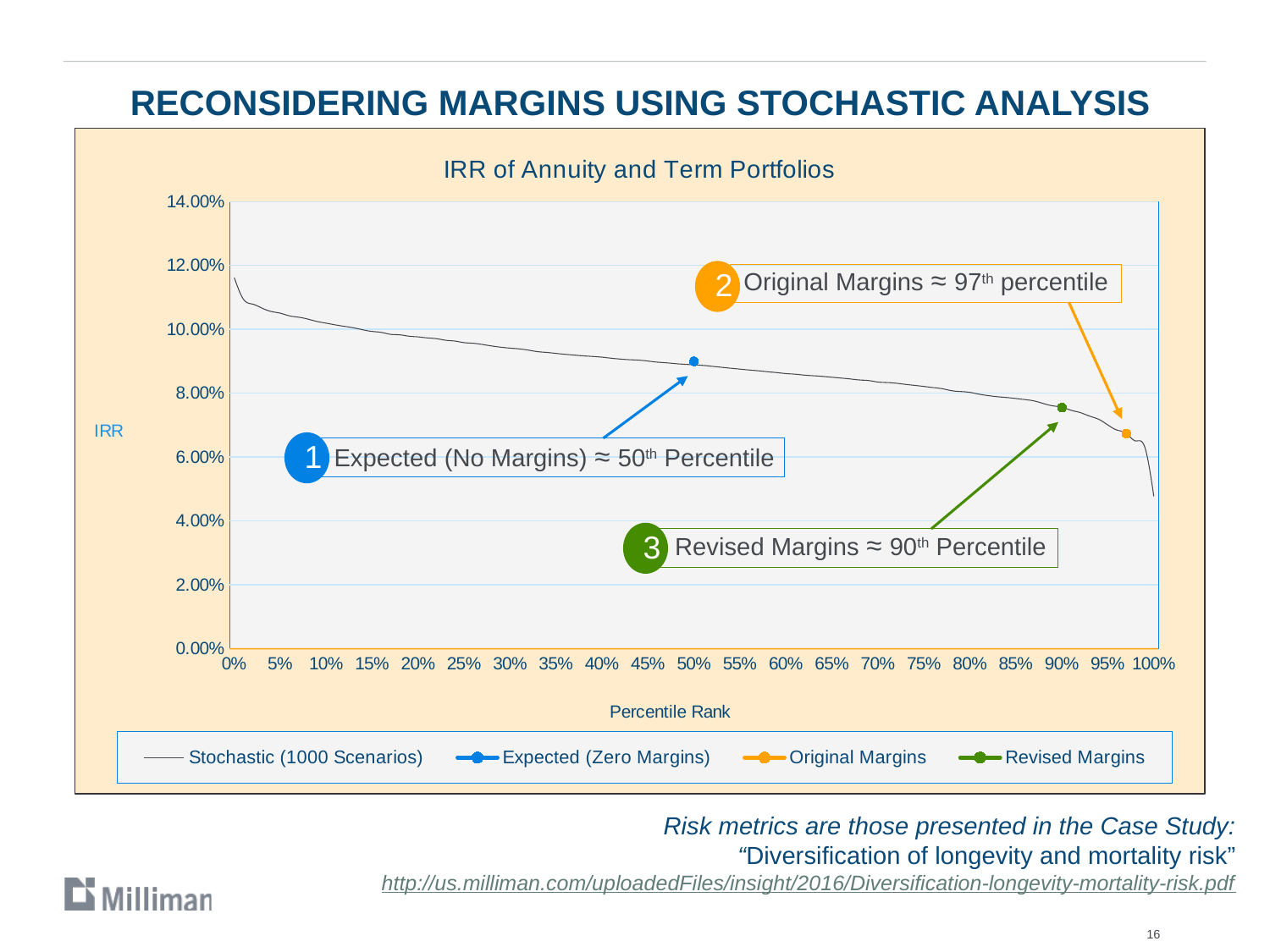
Is the IRR value for the Revised Margins marker greater or less than 6.00%? greater Which has the higher IRR, the Expected (Zero Margins) marker or the Original Margins marker? Expected (Zero Margins) How many series does the chart legend list? 4 Among the three marker series (Expected, Original Margins, Revised Margins), which has the highest IRR? Expected (Zero Margins) Does the Stochastic (1000 Scenarios) line rise or fall as the percentile rank increases along the x axis? Fall According to the annotation on the chart, at approximately which percentile are the Original Margins? 97th percentile Is the IRR value for the Original Margins marker greater or less than 8.00%? less What type of chart is shown on the slide? Line chart Which has the lower IRR, the Revised Margins marker or the Original Margins marker? Original Margins Among the three marker series (Expected, Original Margins, Revised Margins), which has the lowest IRR? Original Margins What is the title of the chart? IRR of Annuity and Term Portfolios Is the IRR value for the Expected (Zero Margins) marker greater or less than 8.00%? greater